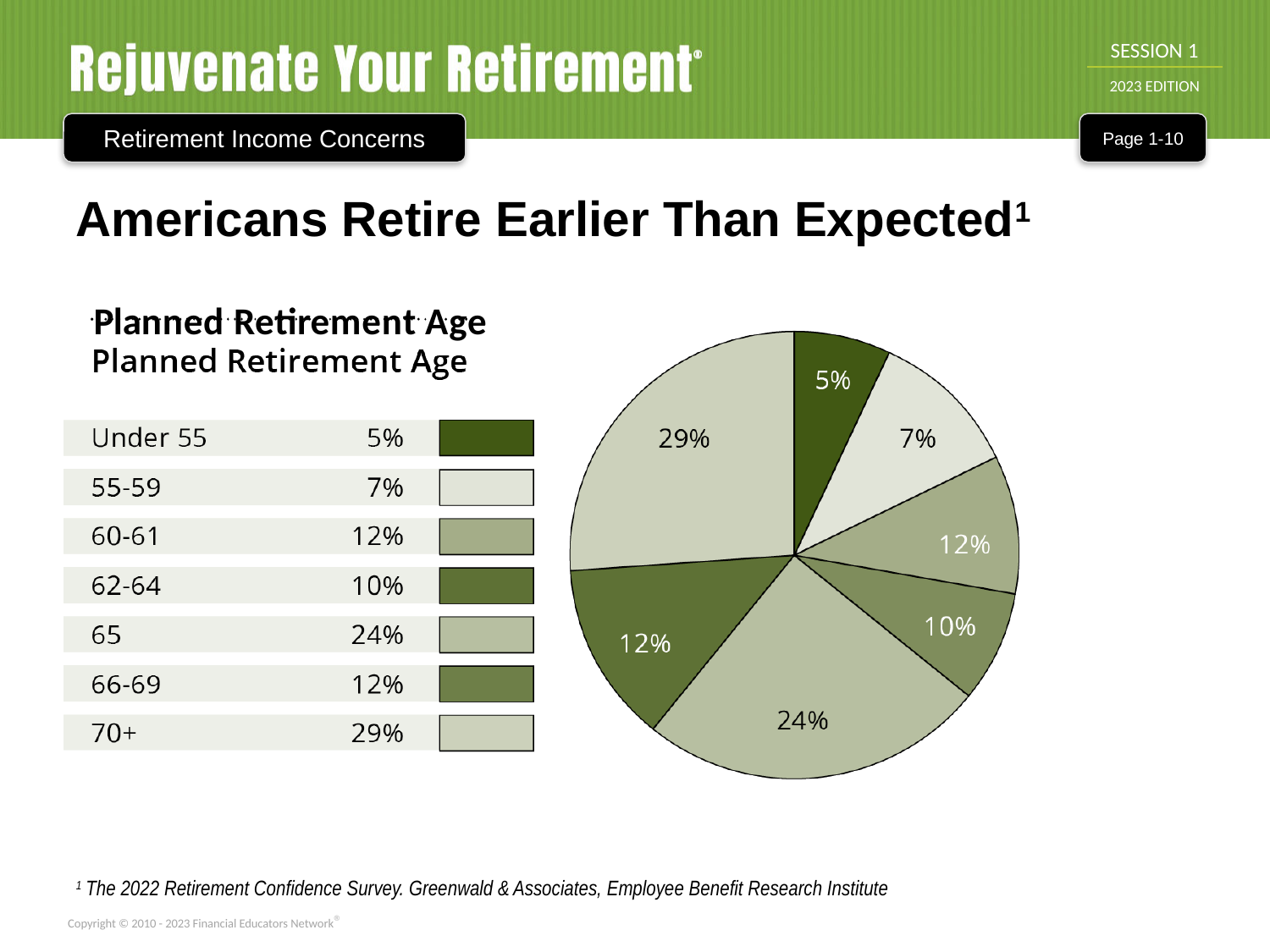
What kind of chart is shown on the slide? Pie chart What share of the pie is for the Under 55 planned retirement age? 5% What share of the pie is for the 62-64 planned retirement age? 10% What is the difference between the shares for 60-61 and Under 55? 7% Which is larger, the share for 55-59 or the share for 62-64? 62-64 What share of the pie is for the 65 planned retirement age? 24% What is the difference between the shares for 70+ and 65? 5% What is the title of the chart? Planned Retirement Age Which planned retirement age category has the largest share of the pie? 70+ Which planned retirement age category has the smallest share of the pie? Under 55 How many categories does the pie chart show? 7 What share of the pie is for the 70+ planned retirement age? 29%